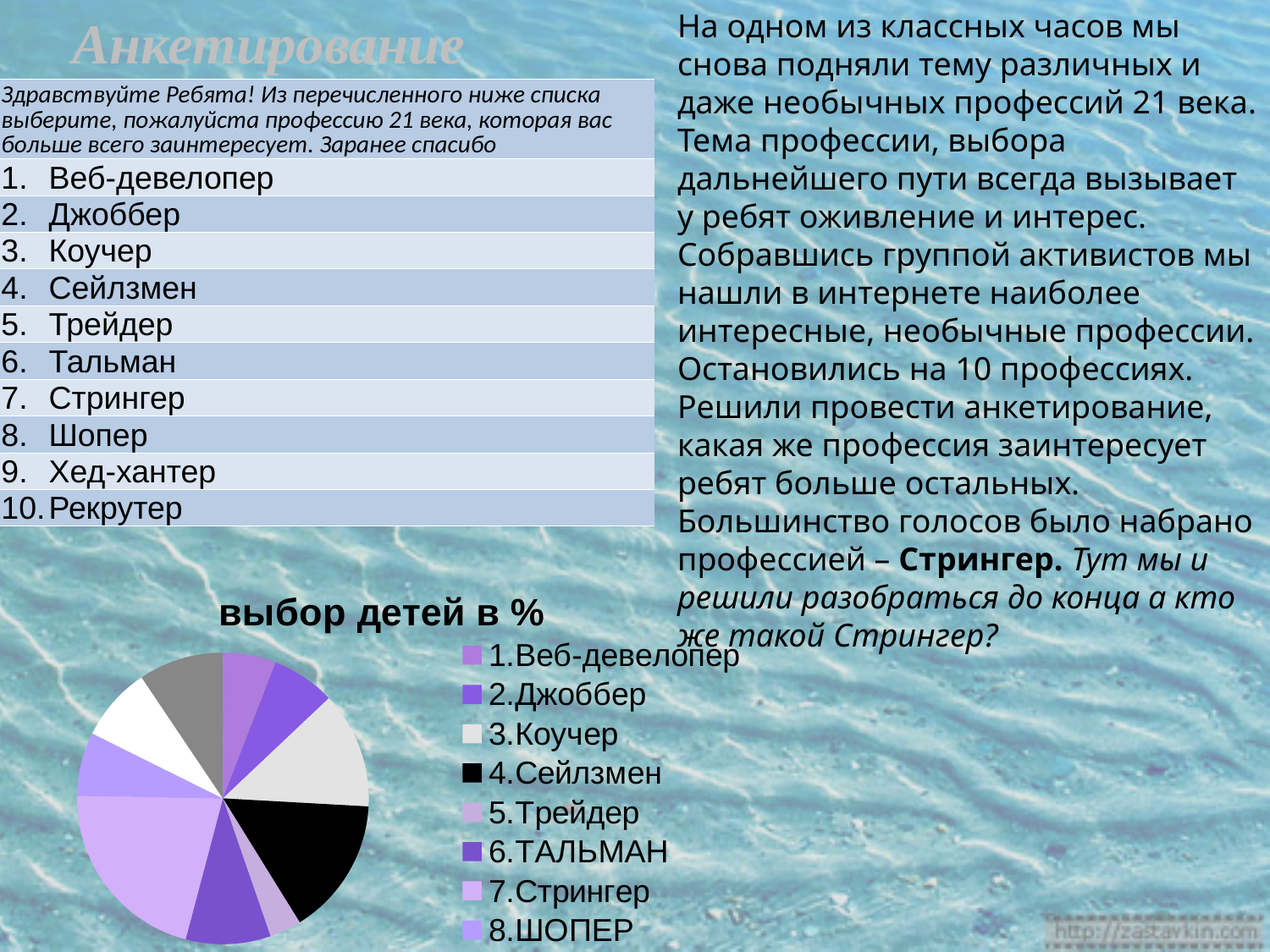
What colour is the slice for 4.Сейлзмен in the pie chart? black Which slice is larger in the pie chart, 4.Сейлзмен or 5.Трейдер? 4.Сейлзмен What is the title of the pie chart? выбор детей в % What kind of chart is shown on the slide? pie chart Which slice is larger in the pie chart, 7.Стрингер or 1.Веб-девелопер? 7.Стрингер Which profession has the largest slice in the pie chart? 7.Стрингер How many slices does the pie chart have? 10